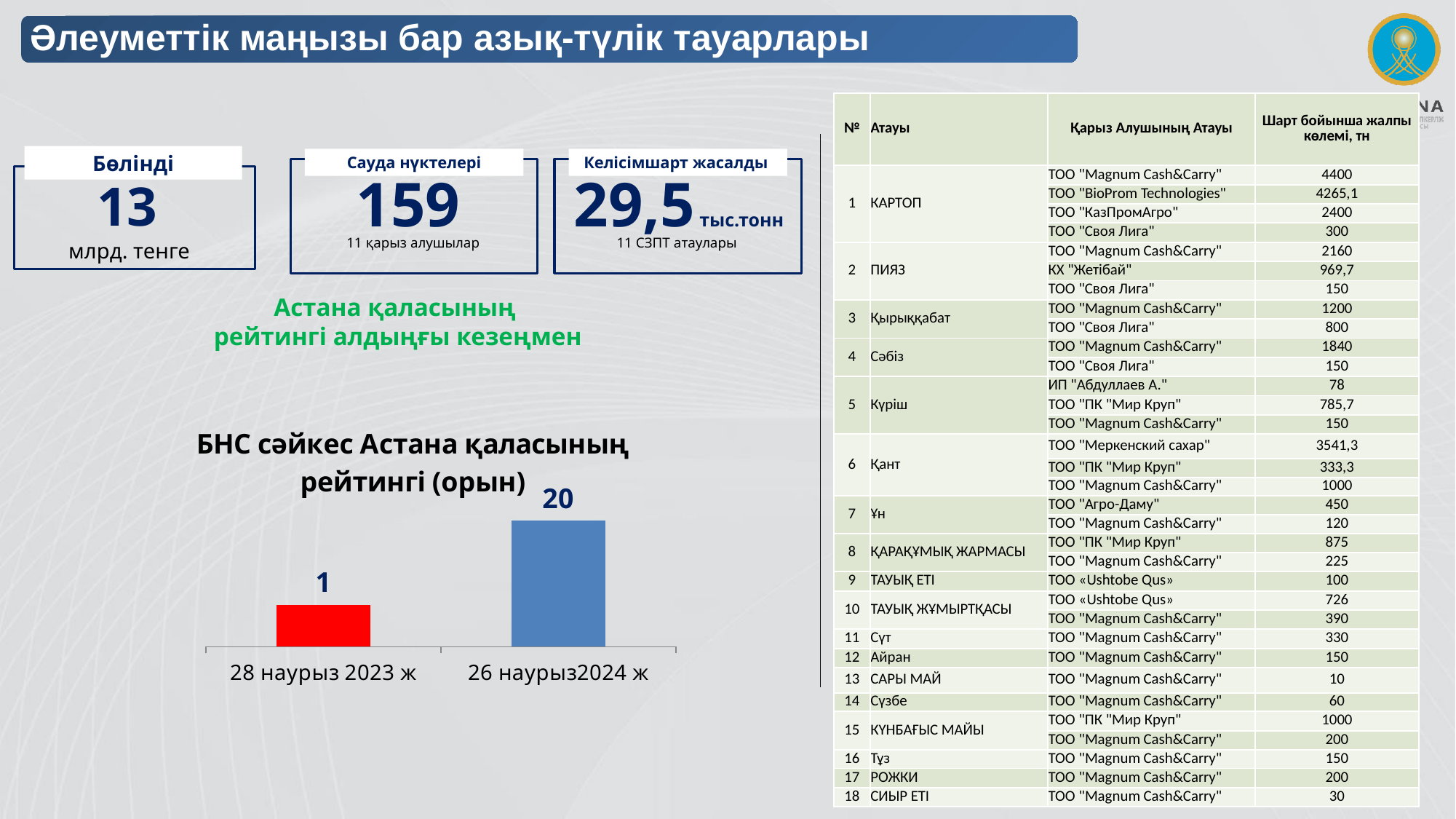
What is the difference between the values for 26 наурыз2024 ж and 28 наурыз 2023 ж in the bar chart? 19 How many categories are shown in the bar chart? 2 Which category has the lowest value in the bar chart? 28 наурыз 2023 ж What is the value for 28 наурыз 2023 ж in the bar chart? 1 Which is larger in the bar chart: the value for 28 наурыз 2023 ж or the value for 26 наурыз2024 ж? 26 наурыз2024 ж Which category has the highest value in the bar chart? 26 наурыз2024 ж What is the title of the bar chart? БНС сәйкес Астана қаласының рейтингі (орын) What kind of chart is shown on the slide? bar chart What colour is the bar for 28 наурыз 2023 ж in the bar chart? red What is the value for 26 наурыз2024 ж in the bar chart? 20 Do the values in the bar chart rise or fall from left to right along the x axis? rise